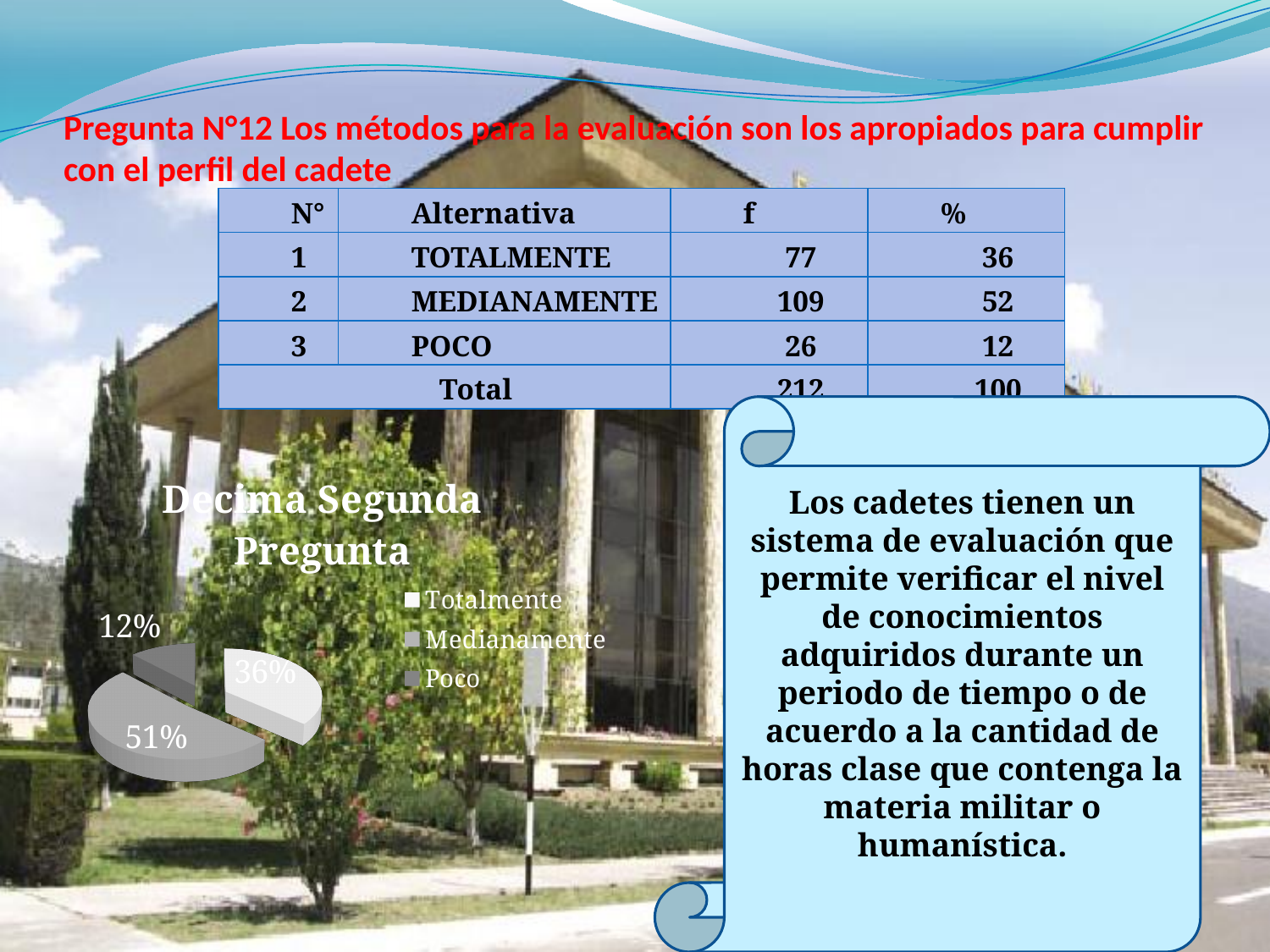
What is the difference between the largest and smallest slices of the pie chart? 39 percentage points Is the largest slice of the pie chart greater or less than 50%? greater How many slices does the pie chart have? 3 What is the largest percentage shown on the pie chart? 51% Which is larger on the pie chart, the 36% slice or the 12% slice? the 36% slice What kind of chart is shown on the slide? pie chart How many entries does the pie chart's legend list? 3 What is the smallest percentage shown on the pie chart? 12% What is the title of the pie chart? Decima Segunda Pregunta What are the legend entries of the pie chart? Totalmente, Medianamente, Poco